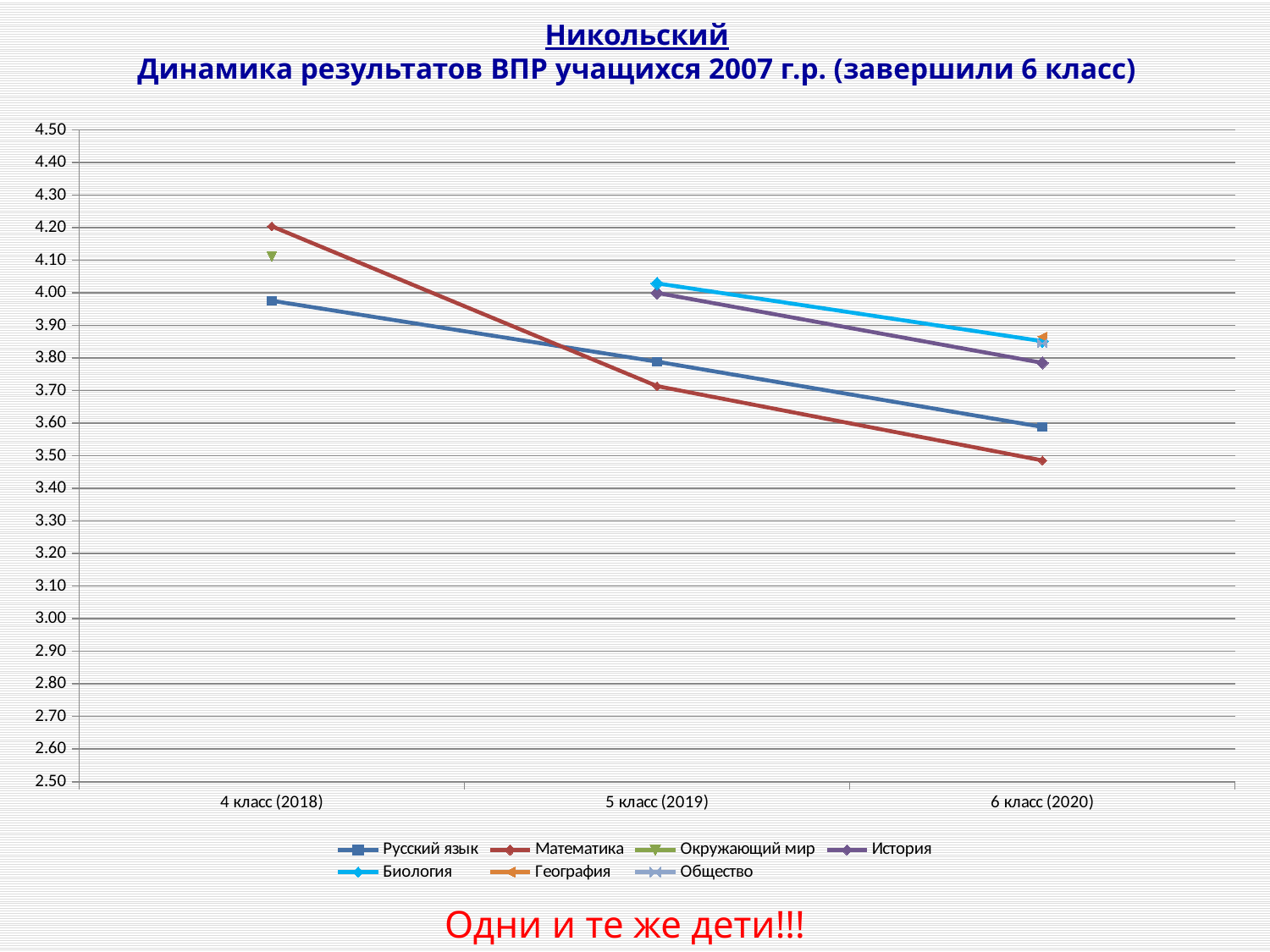
What kind of chart is shown on the slide? line chart Is the value for Русский язык at 5 класс (2019) greater or less than 3.70? greater Is the value for Математика at 6 класс (2020) greater or less than 3.60? less How many categories are shown on the x axis? 3 At 4 класс (2018), which is larger: Математика or Русский язык? Математика Do the values for Русский язык rise or fall from 4 класс (2018) to 6 класс (2020)? fall Which series has the lowest value at 6 класс (2020)? Математика Do the values for Математика rise or fall from 4 класс (2018) to 6 класс (2020)? fall At 6 класс (2020), which is larger: Русский язык or Математика? Русский язык Is the value for Математика at 4 класс (2018) greater or less than 4.00? greater How many series does the legend list? 7 Which series in the legend has a data point only at 4 класс (2018)? Окружающий мир